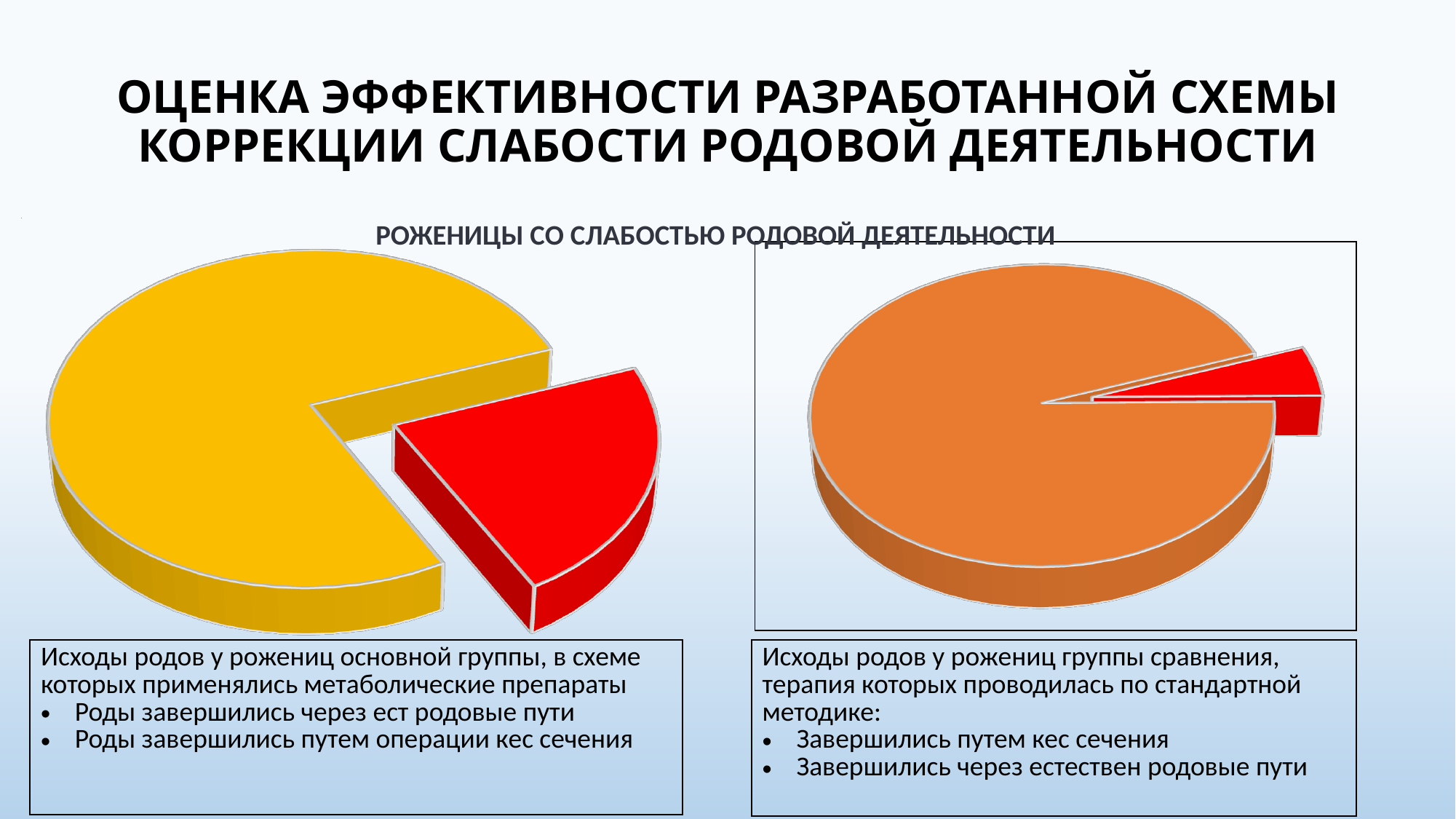
In the right pie chart, which colour slice is the smallest? red Is the red slice larger in the left pie chart or in the right pie chart? left In the left pie chart, which colour slice is pulled out from the rest of the pie? red In the left pie chart, which colour slice is the largest? yellow How many slices does the right pie chart have? 2 In the right pie chart, which colour slice is the largest? orange How many slices does the left pie chart have? 2 What kind of chart is the left chart on the slide? pie chart What kind of chart is the right chart on the slide? pie chart In the left pie chart, which colour slice is the smallest? red In the right pie chart, is the orange slice larger or smaller than the red slice? larger What is the title shown above the two pie charts? РОЖЕНИЦЫ СО СЛАБОСТЬЮ РОДОВОЙ ДЕЯТЕЛЬНОСТИ